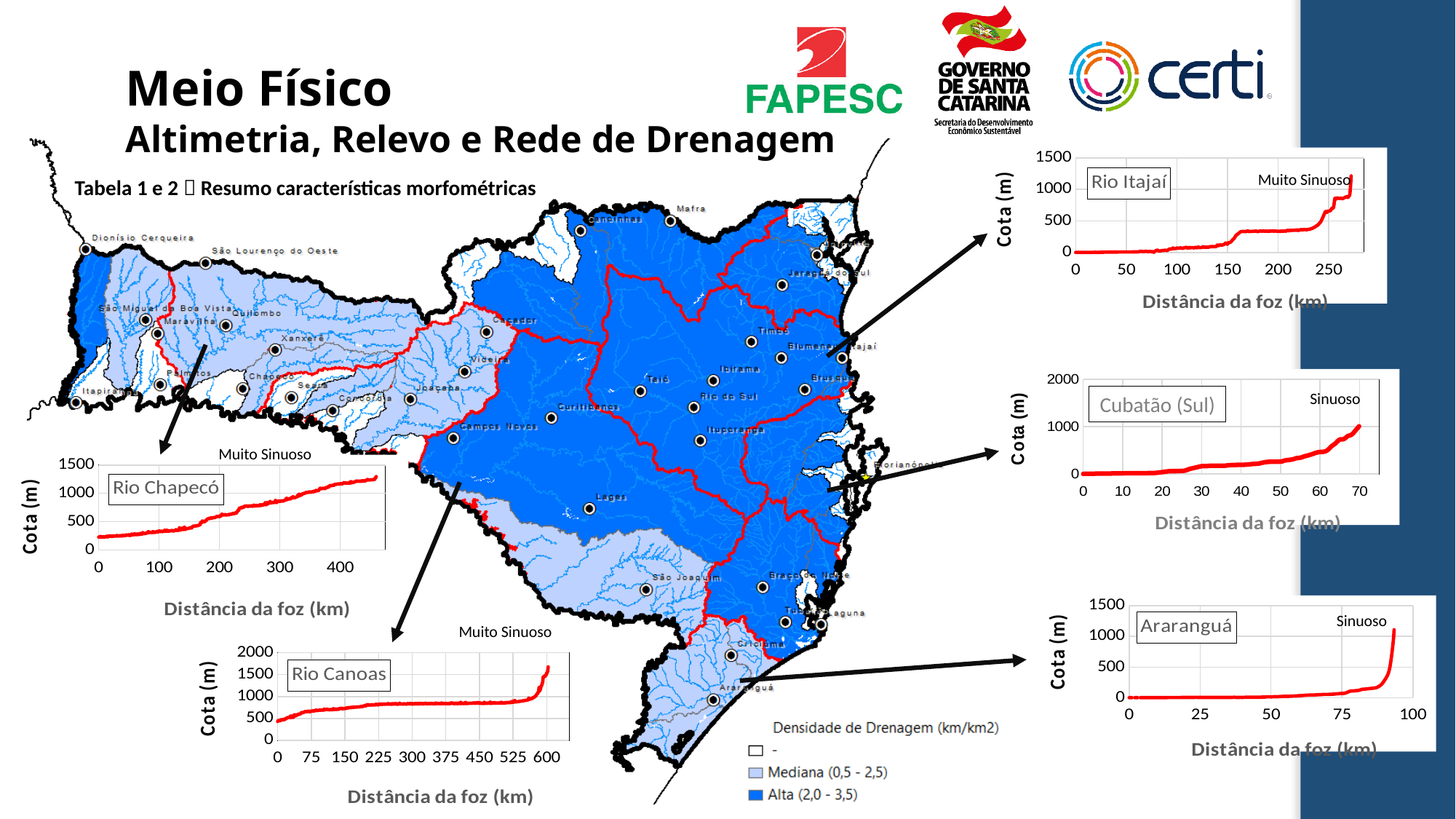
In the Rio Canoas chart, do the values rise or fall along the x axis? rise How many river profile charts are shown on the slide? 5 What kind of chart is the Cubatão (Sul) chart? line chart In the Rio Chapecó chart, is the value at 400 km greater or less than 1000? greater In the Araranguá chart, is the value at 50 km greater or less than 500? less What sinuosity label is shown on the Rio Itajaí chart? Muito Sinuoso In the Rio Itajaí chart, is the value at 100 km greater or less than 500? less What kind of chart is the Rio Chapecó chart? line chart In the Rio Itajaí chart, do the values rise or fall as the distance from the mouth increases? rise What sinuosity label is shown on the Araranguá chart? Sinuoso